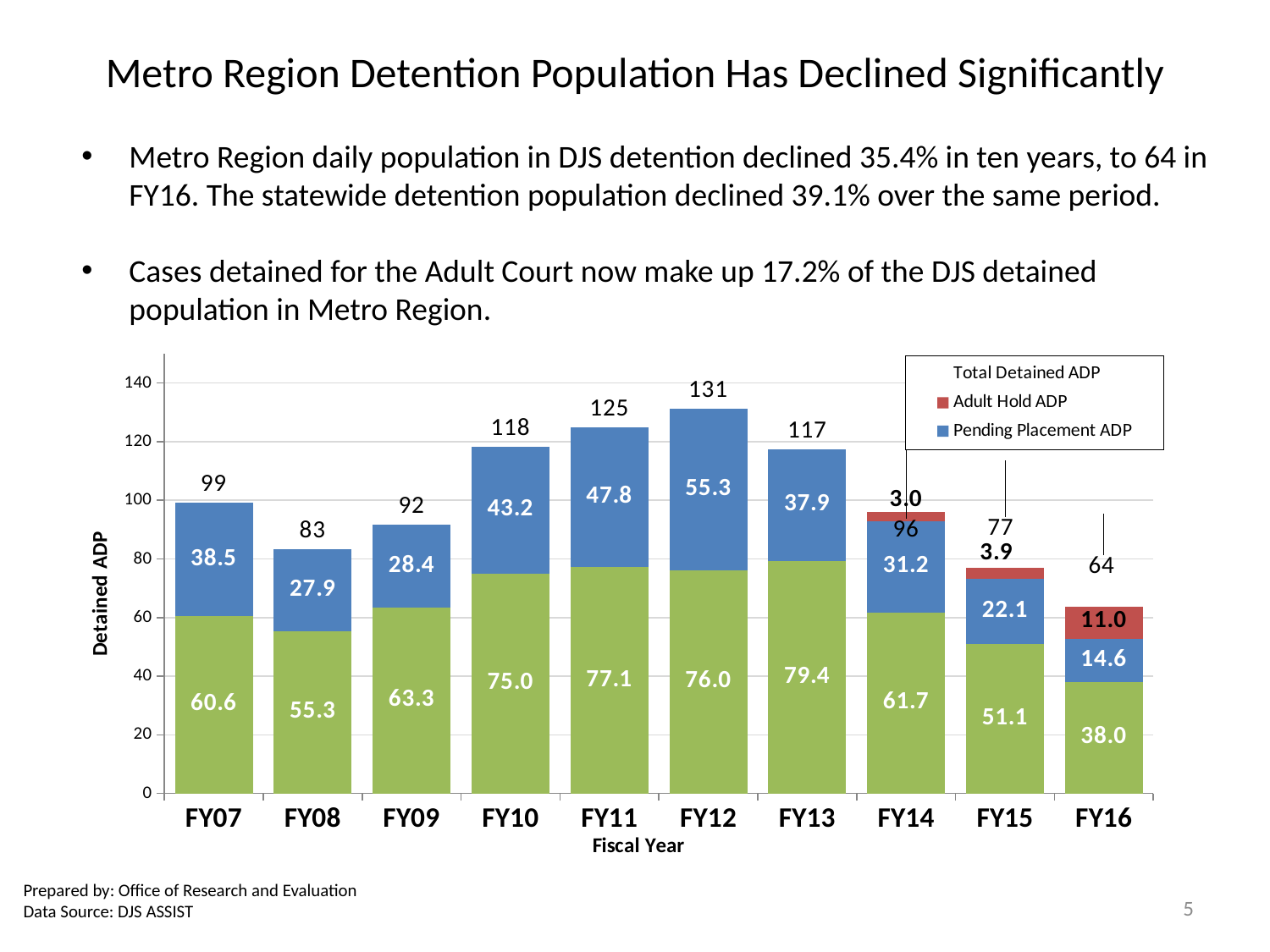
What is the value of the green segment of the FY13 bar? 79.4 Which fiscal year has the highest total detained ADP? FY12 What is the Adult Hold ADP value for FY16? 11.0 Is the total detained ADP for FY09 greater or less than 100? less Do the total detained ADP values rise or fall from FY12 to FY16? Fall What is the difference between the total detained ADP in FY07 and in FY16? 35 What is the total detained ADP for FY14? 96 How many fiscal years are shown on the x axis? 10 What is the Pending Placement ADP value for FY12? 55.3 Which is larger, the Pending Placement ADP for FY10 or for FY11? FY11 What kind of chart is shown on the slide? Stacked bar chart Which fiscal year has the lowest total detained ADP? FY16